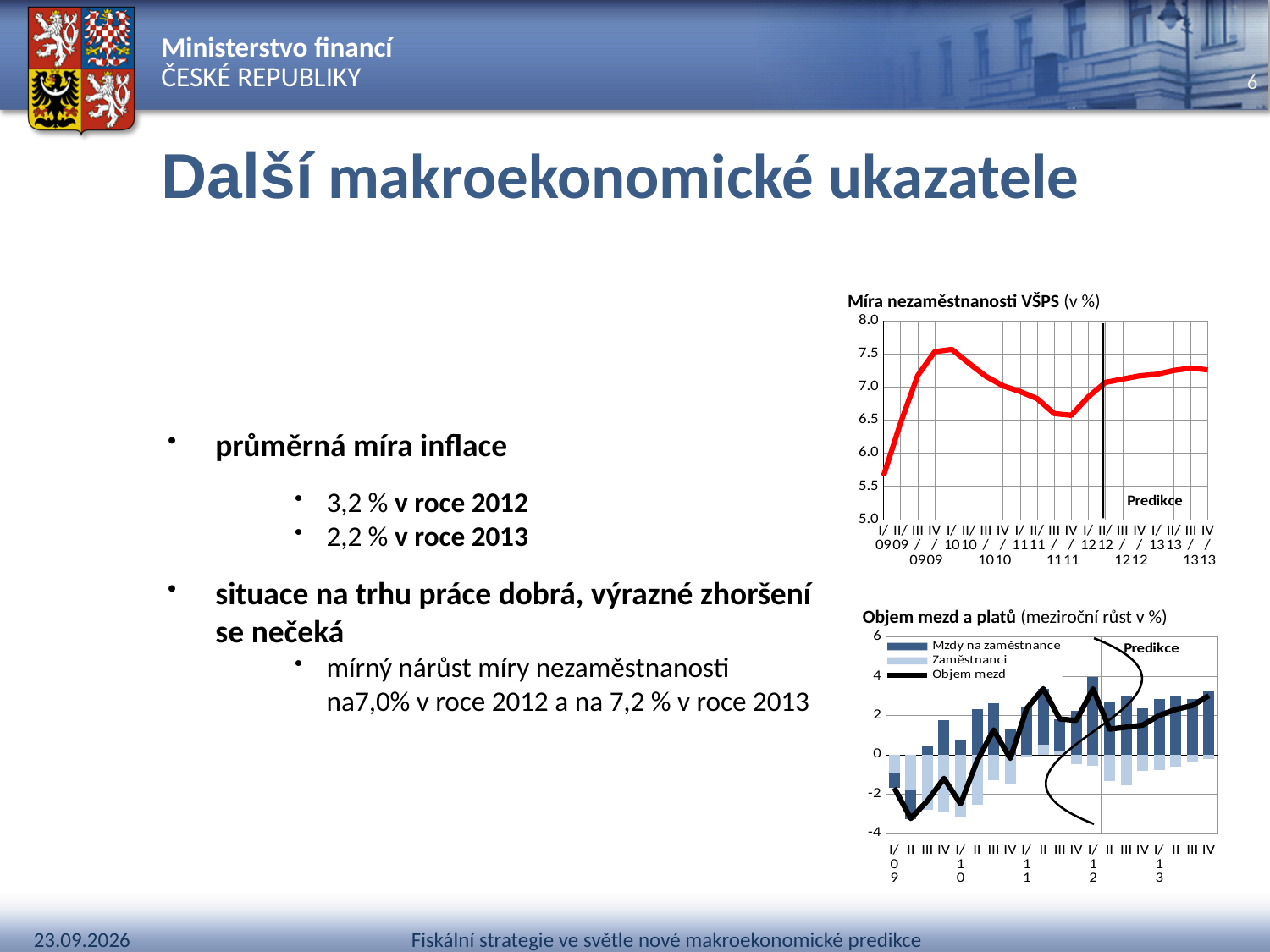
In the 'Míra nezaměstnanosti VŠPS' chart, is the value for II/11 greater or less than 7.0? less What label marks the forecast period in both charts on the slide? Predikce In the 'Míra nezaměstnanosti VŠPS' chart, in which quarter is the unemployment rate lowest? I/09 In the 'Míra nezaměstnanosti VŠPS' chart, in which quarter does the unemployment rate reach its highest value? I/10 In the 'Objem mezd a platů' chart, is the 'Objem mezd' value for II/09 greater or less than -2? less How many series does the legend of the 'Objem mezd a platů' chart list? 3 In the 'Míra nezaměstnanosti VŠPS' chart, which is larger: the value for III/09 or the value for II/11? III/09 What kind of chart is the 'Míra nezaměstnanosti VŠPS' chart? line chart In the 'Objem mezd a platů' chart, is the 'Objem mezd' value for IV/13 greater or less than 2? greater In the 'Objem mezd a platů' chart, which series is drawn as a black line? Objem mezd In the 'Míra nezaměstnanosti VŠPS' chart, does the unemployment rate rise or fall between III/09 and II/11? fall